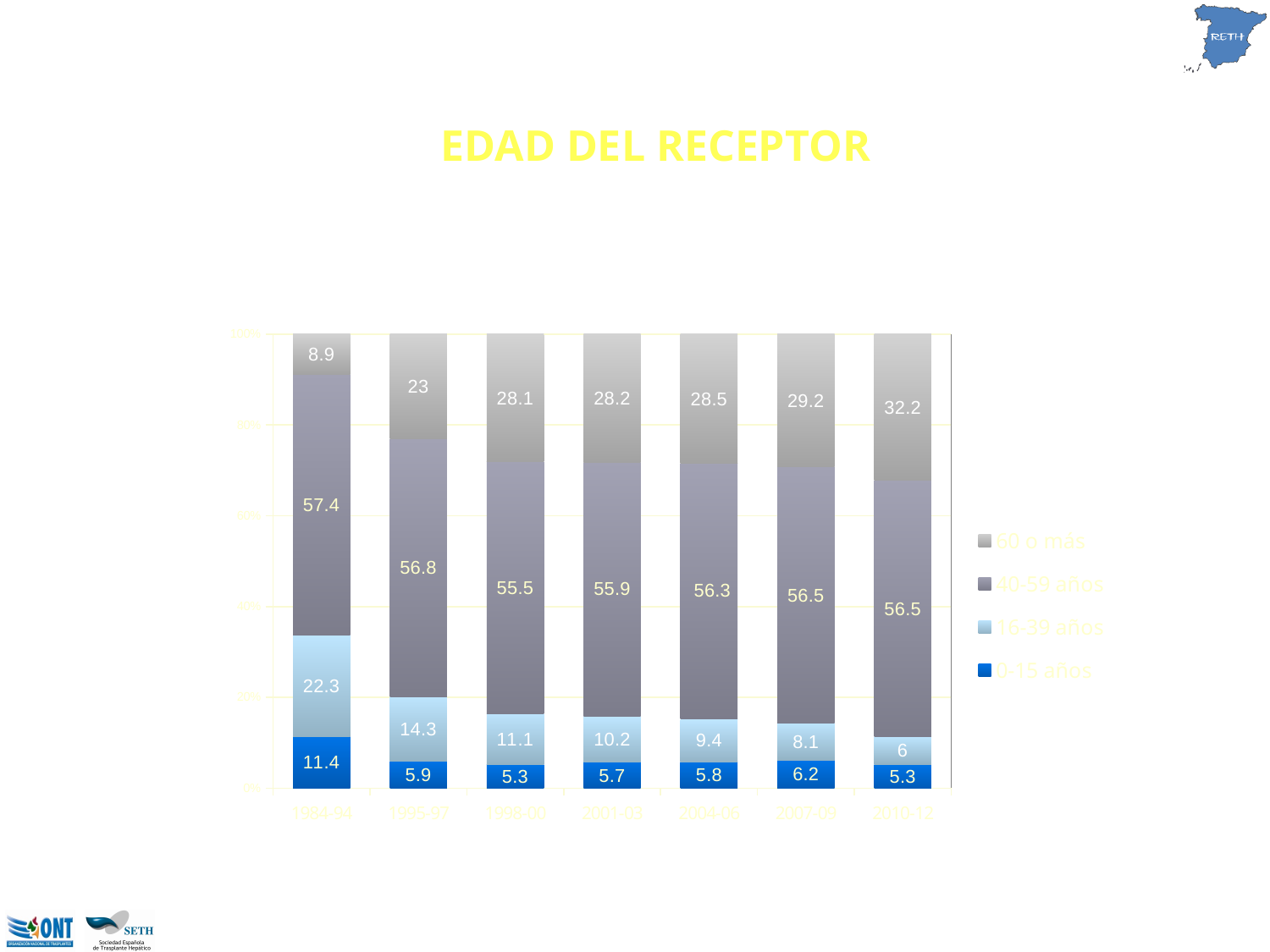
How does the 16-39 años series change from 1984-94 to 2010-12? It falls What is the value for the 16-39 años series in 1995-97? 14.3 What is the value for the 0-15 años series in 1984-94? 11.4 How many periods are shown on the x axis? 7 What is the value for the 60 o más series in 2010-12? 32.2 Which is larger, the 0-15 años value for 2007-09 or for 2004-06? 2007-09 How many series does the legend list? 4 What is the title of the chart? EDAD DEL RECEPTOR What kind of chart is shown on the slide? Stacked bar chart Which period has the highest value for the 60 o más series? 2010-12 What is the difference between the 60 o más values for 2010-12 and 1984-94? 23.3 Which period has the lowest value for the 16-39 años series? 2010-12